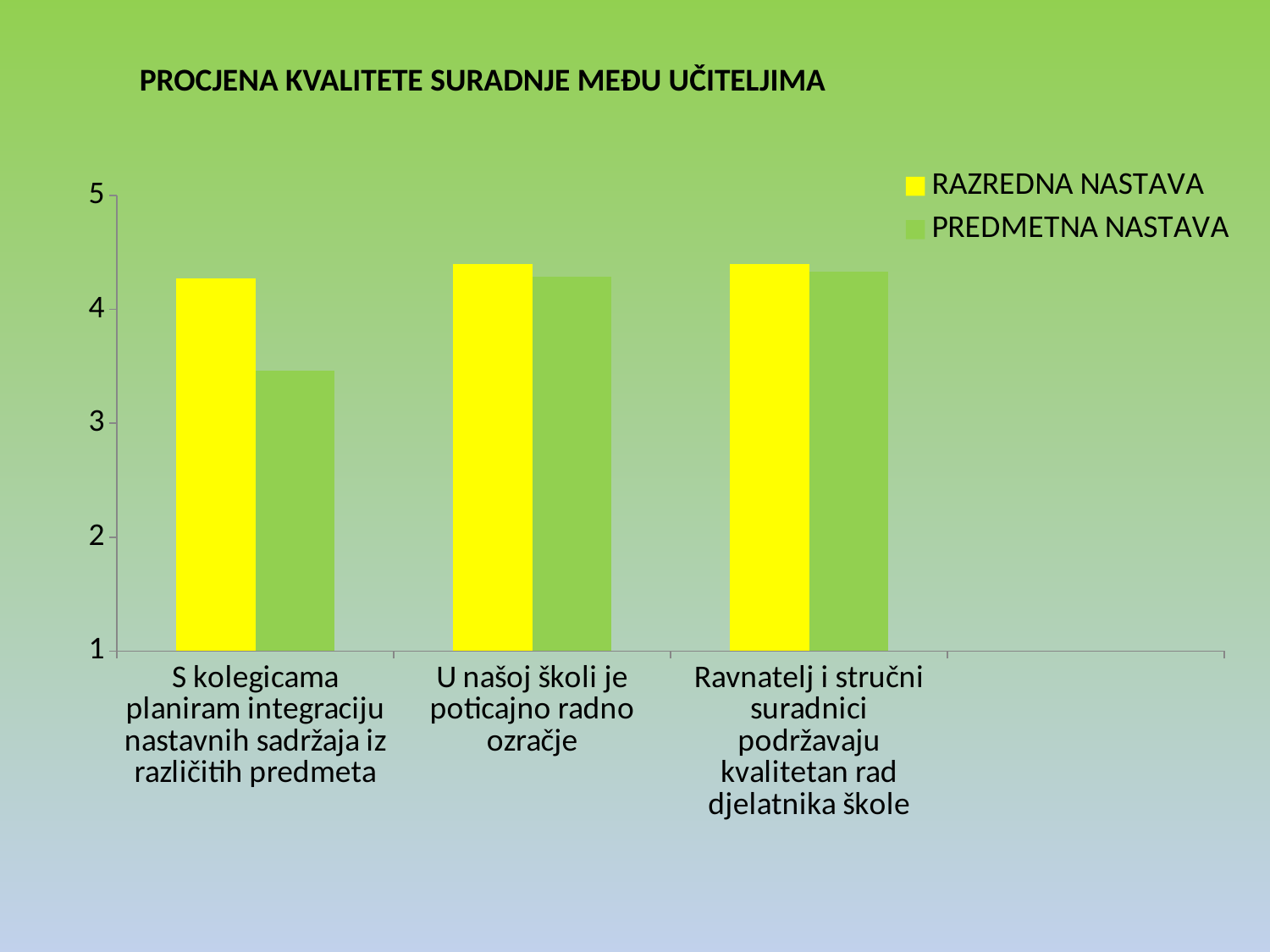
Is the PREDMETNA NASTAVA value for 'S kolegicama planiram integraciju nastavnih sadržaja iz različitih predmeta' greater or less than 3? greater How many categories are shown on the x axis? 3 How many series does the legend list? 2 Is the PREDMETNA NASTAVA value for 'S kolegicama planiram integraciju nastavnih sadržaja iz različitih predmeta' greater or less than 4? less For which category is the PREDMETNA NASTAVA value lowest? S kolegicama planiram integraciju nastavnih sadržaja iz različitih predmeta For 'S kolegicama planiram integraciju nastavnih sadržaja iz različitih predmeta', which series has the larger value, RAZREDNA NASTAVA or PREDMETNA NASTAVA? RAZREDNA NASTAVA Is the RAZREDNA NASTAVA value for 'Ravnatelj i stručni suradnici podržavaju kvalitetan rad djelatnika škole' greater or less than 4? greater What kind of chart is shown on the slide? bar chart What is the title of the chart? PROCJENA KVALITETE SURADNJE MEĐU UČITELJIMA Which series is shown in yellow? RAZREDNA NASTAVA